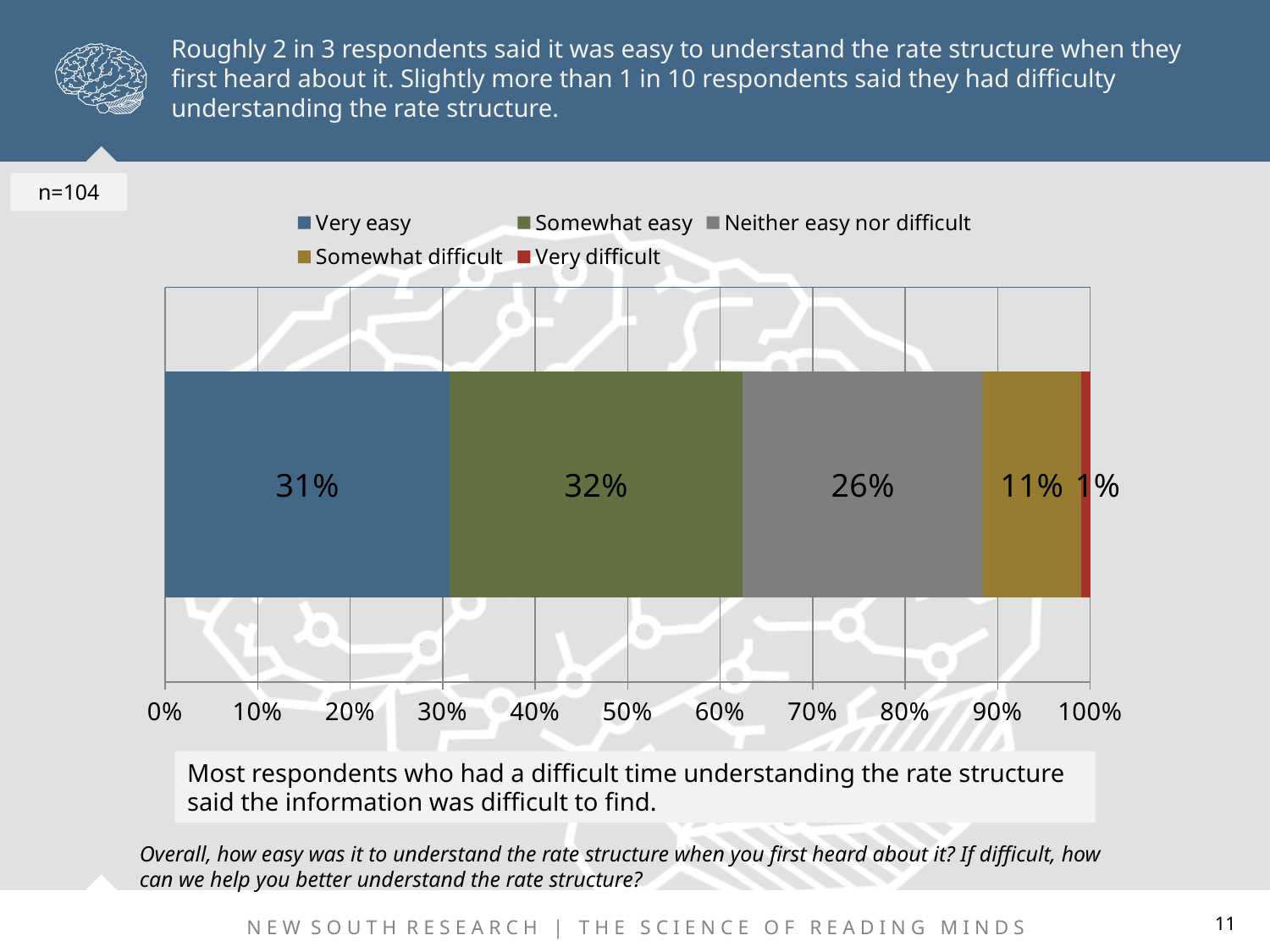
How many series does the legend list? 5 What is the difference between the "Neither easy nor difficult" share and the "Somewhat difficult" share? 15% What is the combined share of "Very easy" and "Somewhat easy" responses? 63% What percentage of respondents answered "Neither easy nor difficult"? 26% What percentage of respondents said it was "Very difficult"? 1% Which is larger, the "Very easy" share or the "Neither easy nor difficult" share? Very easy What kind of chart is shown on the slide? Stacked bar chart Which response category has the smallest share? Very difficult What percentage of respondents said it was "Somewhat easy" to understand the rate structure? 32% Which response category has the largest share? Somewhat easy What percentage of respondents said it was "Very easy" to understand the rate structure? 31% What percentage of respondents said it was "Somewhat difficult"? 11%